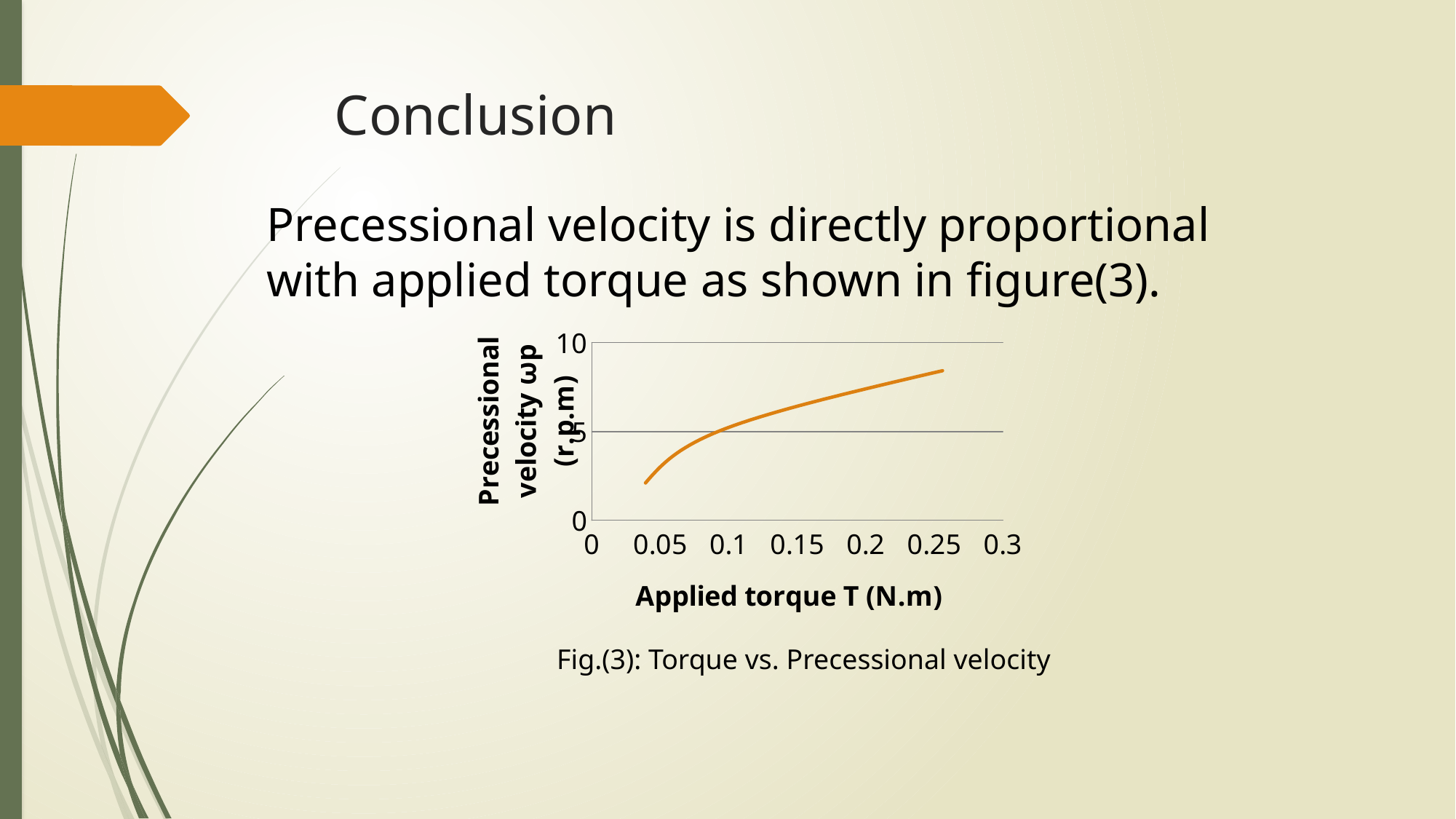
Which is larger, the precessional velocity at 0.05 N.m or at 0.25 N.m? 0.25 N.m Is the precessional velocity at an applied torque of 0.25 N.m greater or less than 10? less What kind of chart is shown in Fig.(3)? line chart Is the precessional velocity at an applied torque of 0.15 N.m greater or less than 5? greater Is the precessional velocity at an applied torque of 0.2 N.m greater or less than 5? greater Does the precessional velocity rise or fall as the applied torque increases along the x axis? rise What is the highest value shown on the x axis of the chart? 0.3 What is the highest value shown on the y axis of the chart? 10 What is the label of the x axis of the chart? Applied torque T (N.m) What is the caption given below the chart? Fig.(3): Torque vs. Precessional velocity